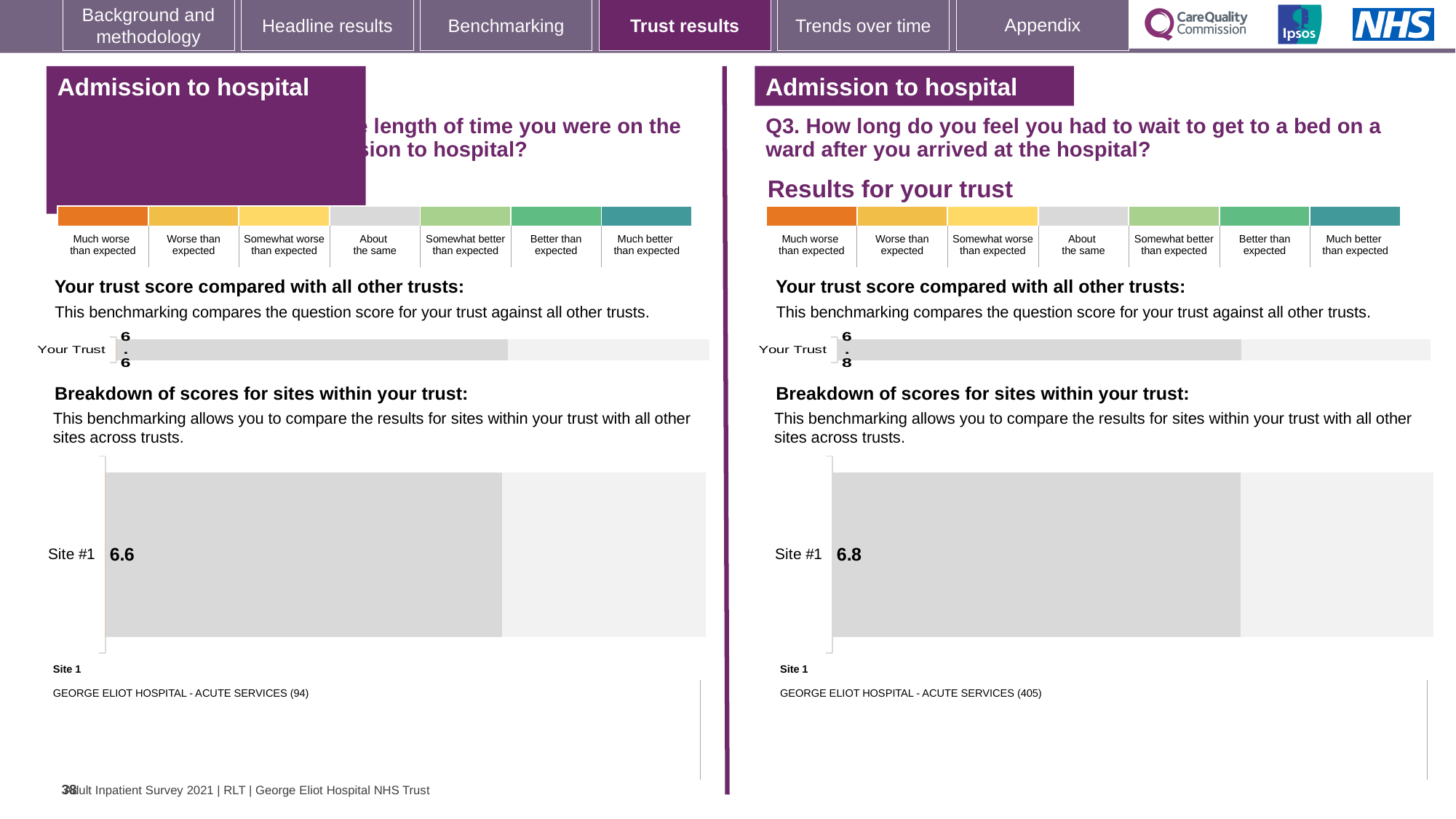
Which is larger: the Site #1 score in the left-hand breakdown chart or the Site #1 score in the right-hand (Q3) breakdown chart? The right-hand (Q3) chart On the right half of the slide (Q3), what is the score shown for Your Trust in the 'Your trust score compared with all other trusts' chart? 6.8 In the 'Breakdown of scores for sites within your trust' chart on the left half of the slide, what is the score for Site #1? 6.6 What is the difference between the Site #1 score in the right-hand (Q3) breakdown chart and the Site #1 score in the left-hand breakdown chart? 0.2 How many sites are shown in the 'Breakdown of scores for sites within your trust' chart on the left half of the slide? 1 What is the name of the site labelled Site 1 beneath the breakdown chart on the left half of the slide? GEORGE ELIOT HOSPITAL - ACUTE SERVICES (94) In the 'Breakdown of scores for sites within your trust' chart on the right half of the slide (Q3), what is the score for Site #1? 6.8 What is the difference between the Your Trust score on the right half of the slide (Q3) and the Your Trust score on the left half of the slide? 0.2 How many sites are shown in the 'Breakdown of scores for sites within your trust' chart on the right half of the slide (Q3)? 1 On the left half of the slide, what is the score shown for Your Trust in the 'Your trust score compared with all other trusts' chart? 6.6 What is the name of the site labelled Site 1 beneath the breakdown chart on the right half of the slide (Q3)? GEORGE ELIOT HOSPITAL - ACUTE SERVICES (405) What kind of chart is used to show the Site #1 score on the right half of the slide (Q3)? Bar chart